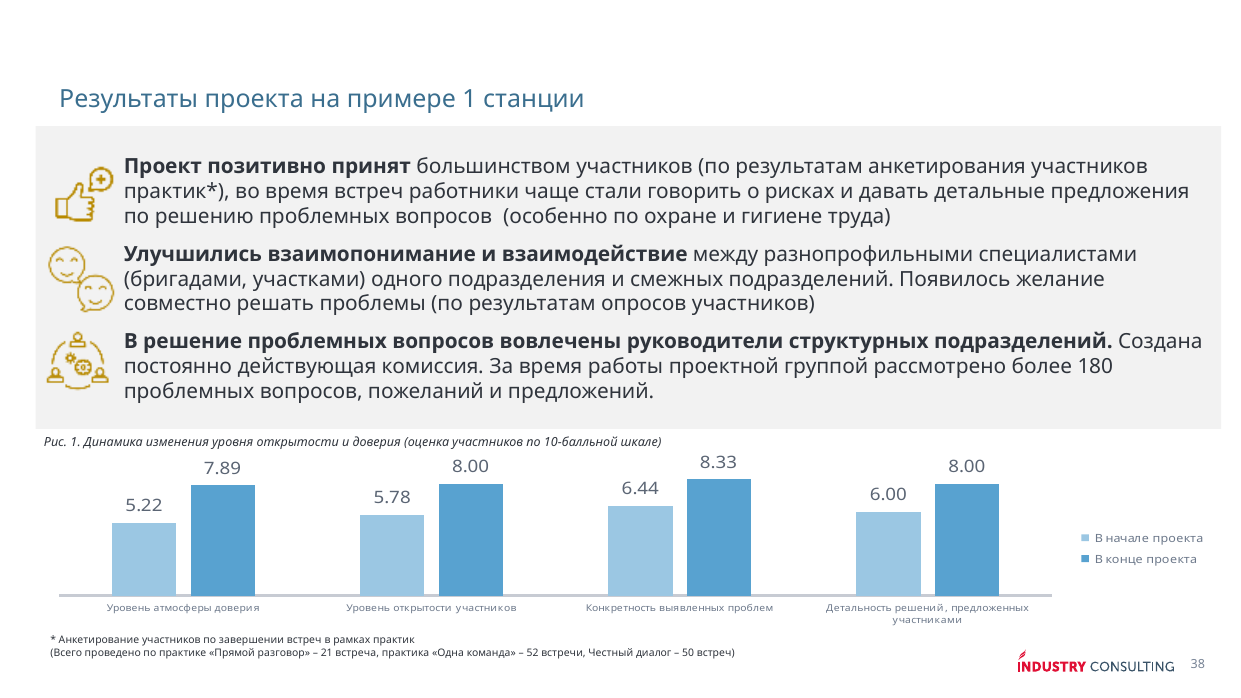
Какая разница между значениями в начале и в конце проекта по показателю «Уровень открытости участников»? 2.22 Какой тип диаграммы использован на слайде? Столбчатая (bar chart) По какому показателю значение в конце проекта самое высокое? Конкретность выявленных проблем Сколько рядов данных указано в легенде диаграммы? 2 На сколько выросло значение показателя «Уровень атмосферы доверия» к концу проекта по сравнению с началом? 2.67 Какое значение показателя «Уровень открытости участников» в начале проекта? 5.78 По какому показателю значение в начале проекта самое низкое? Уровень атмосферы доверия Какое значение показателя «Детальность решений, предложенных участниками» в конце проекта? 8.00 Какое значение показателя «Конкретность выявленных проблем» в конце проекта? 8.33 Какое значение показателя «Уровень атмосферы доверия» в начале проекта? 5.22 Что больше: значение «Конкретность выявленных проблем» в начале проекта или значение «Детальность решений, предложенных участниками» в начале проекта? Конкретность выявленных проблем Сколько показателей (категорий) представлено на диаграмме? 4